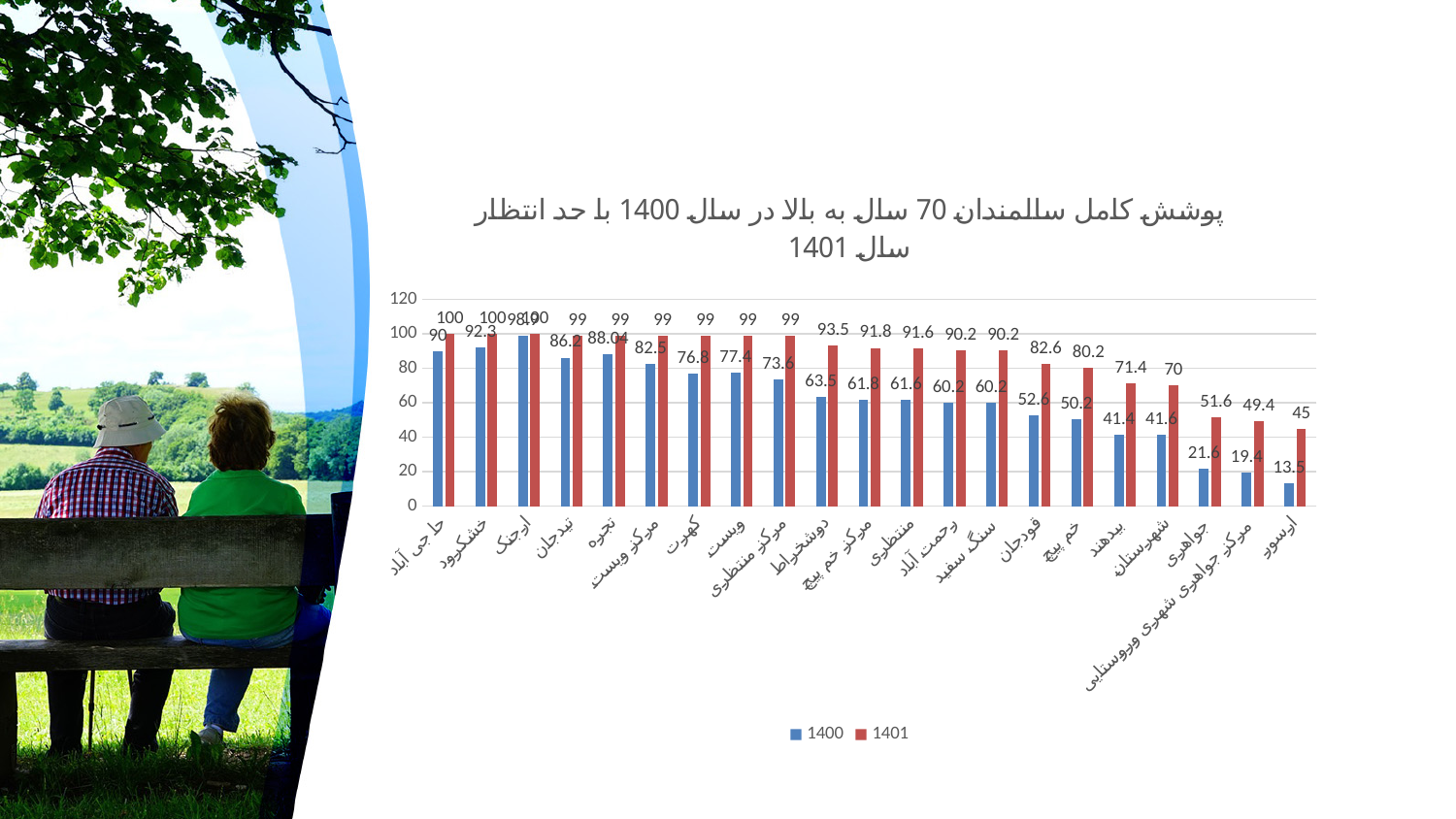
Which category has the lowest 1400 value? ارسور How many series does the legend list? 2 What is the difference between the 1401 and 1400 values for خم پیچ? 30 What is the 1400 value for حاجی آباد? 90 Which is larger, the 1400 value for کهرت or the 1400 value for جواهری? کهرت What is the 1400 value for قودجان? 52.6 What is the 1401 value for بیدهند? 71.4 How many categories are shown on the x axis? 21 What type of chart is shown on the slide? bar chart Which series is shown in red in the legend? 1401 What is the 1401 value for دوشخراط? 93.5